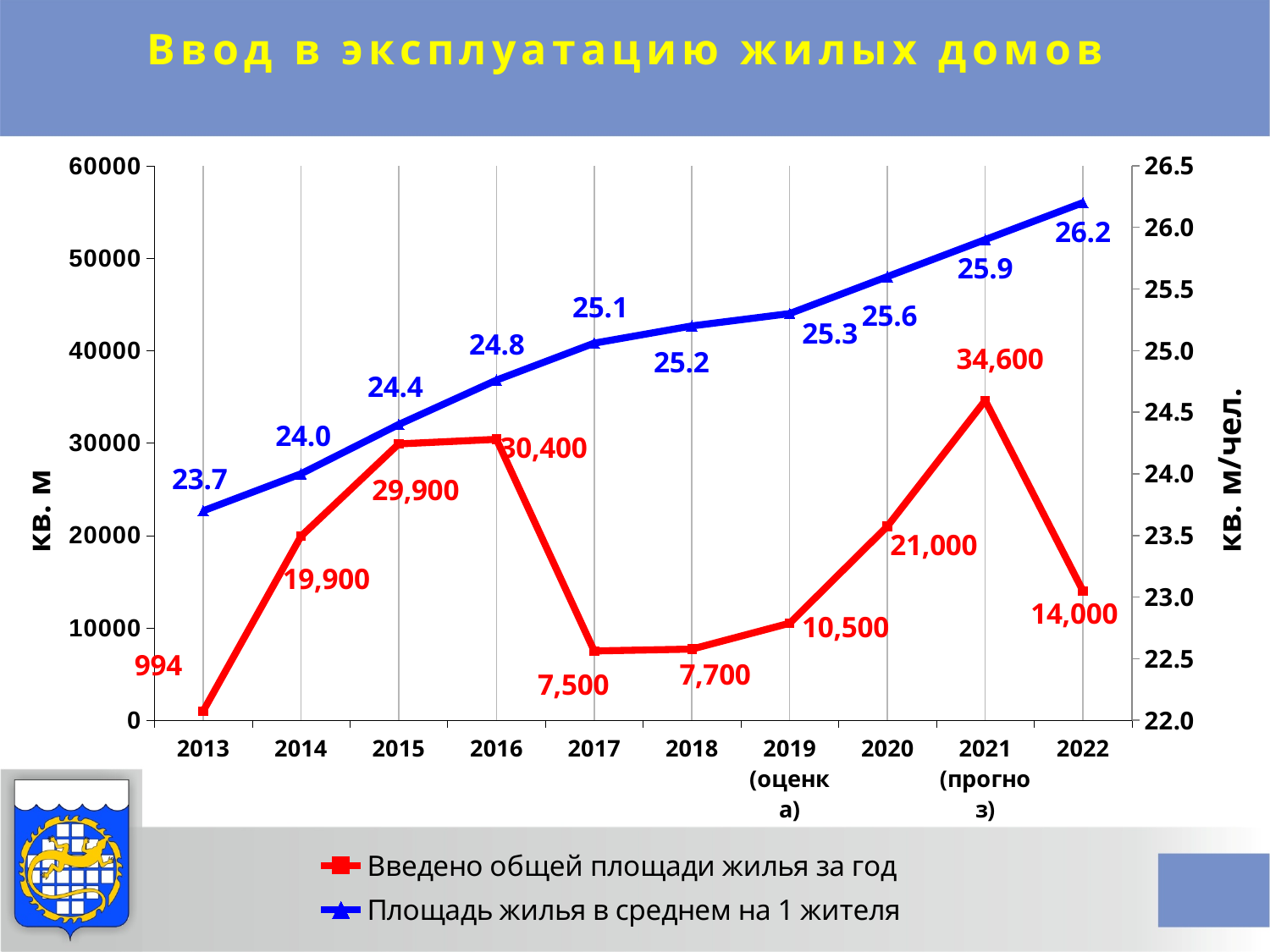
In which year is the value of "Введено общей площади жилья за год" the highest? 2021 (прогноз) What value does the series "Площадь жилья в среднем на 1 жителя" show for 2013? 23.7 What kind of chart is shown on the slide? line chart What value does the series "Введено общей площади жилья за год" show for 2017? 7,500 What is the difference between the "Введено общей площади жилья за год" values for 2016 and 2015? 500 How many series does the legend list? 2 Which year has the larger value for "Введено общей площади жилья за год": 2014 or 2020? 2020 What value does the series "Введено общей площади жилья за год" show for 2021 (прогноз)? 34,600 Is the value of "Введено общей площади жилья за год" for 2022 greater or less than 20000? less In which year is the value of "Введено общей площади жилья за год" the lowest? 2013 How many years are shown on the x axis? 10 Does the series "Площадь жилья в среднем на 1 жителя" rise or fall from 2013 to 2022? rise